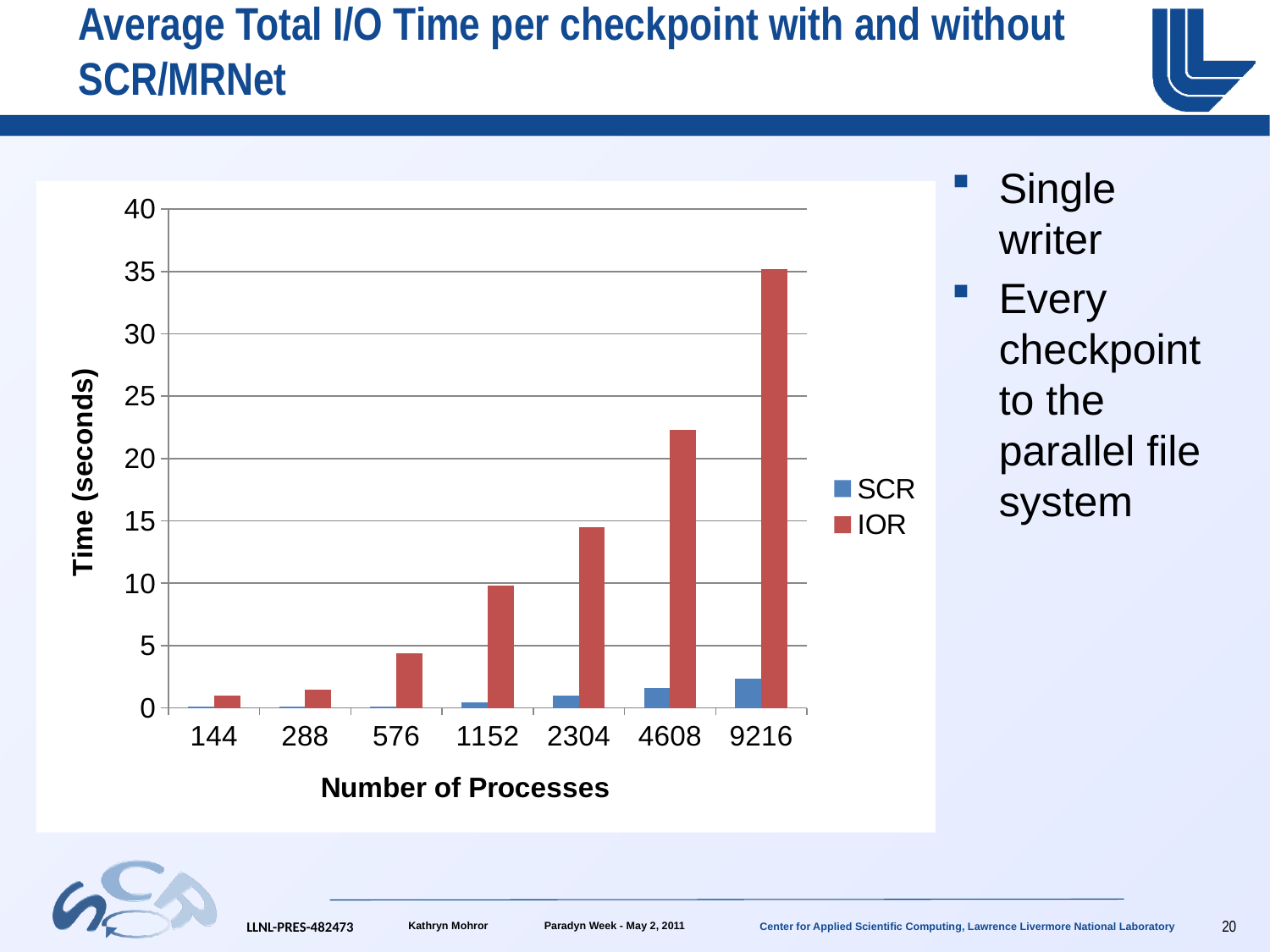
What is the label of the y axis? Time (seconds) For which number of processes is the IOR time highest? 9216 Is the IOR value for 2304 processes greater or less than 10? greater Is the SCR value for 9216 processes greater or less than 5? less How many series does the legend list? 2 Is the IOR value for 9216 processes greater or less than 30? greater Do the IOR values rise or fall as the number of processes increases? rise What kind of chart is shown on the slide? bar chart For which number of processes is the IOR time lowest? 144 How many process counts (categories) are shown on the x axis? 7 At 9216 processes, which series has the larger time, SCR or IOR? IOR